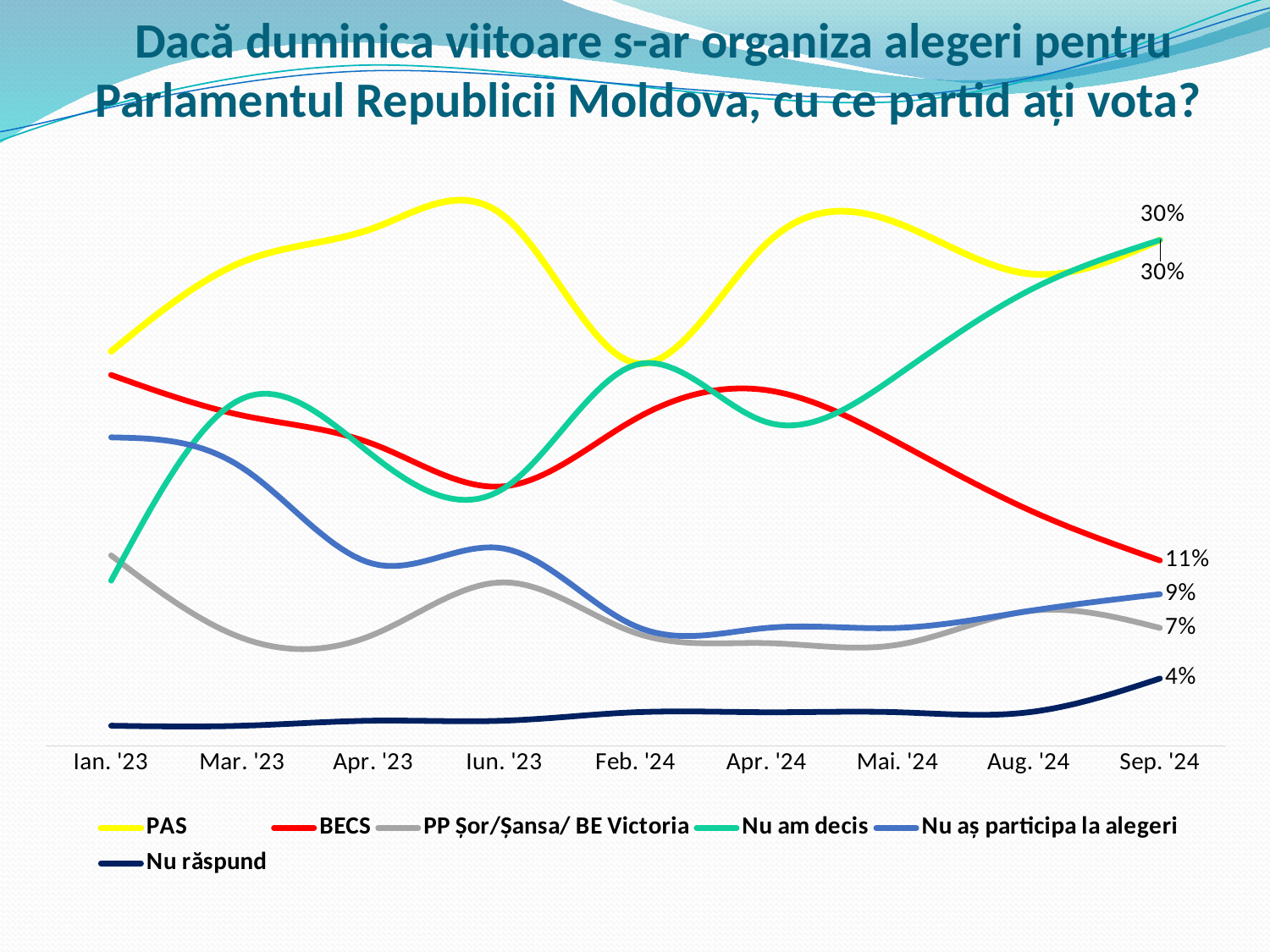
What is the value for Nu răspund at Sep. '24? 4% Does the BECS line rise or fall from Apr. '24 to Sep. '24? fall What is the value for PP Șor/Șansa/ BE Victoria at Sep. '24? 7% How many series does the legend list? 6 What is the value for Nu aș participa la alegeri at Sep. '24? 9% What is the value for BECS at Sep. '24? 11% What is the difference between the BECS value and the Nu răspund value at Sep. '24? 7 percentage points How many time points are shown on the x axis? 9 Which series has the lowest value at Sep. '24? Nu răspund What kind of chart is shown on the slide? line chart At Sep. '24, which is larger: BECS or PP Șor/Șansa/ BE Victoria? BECS What is the value for PAS at Sep. '24? 30%